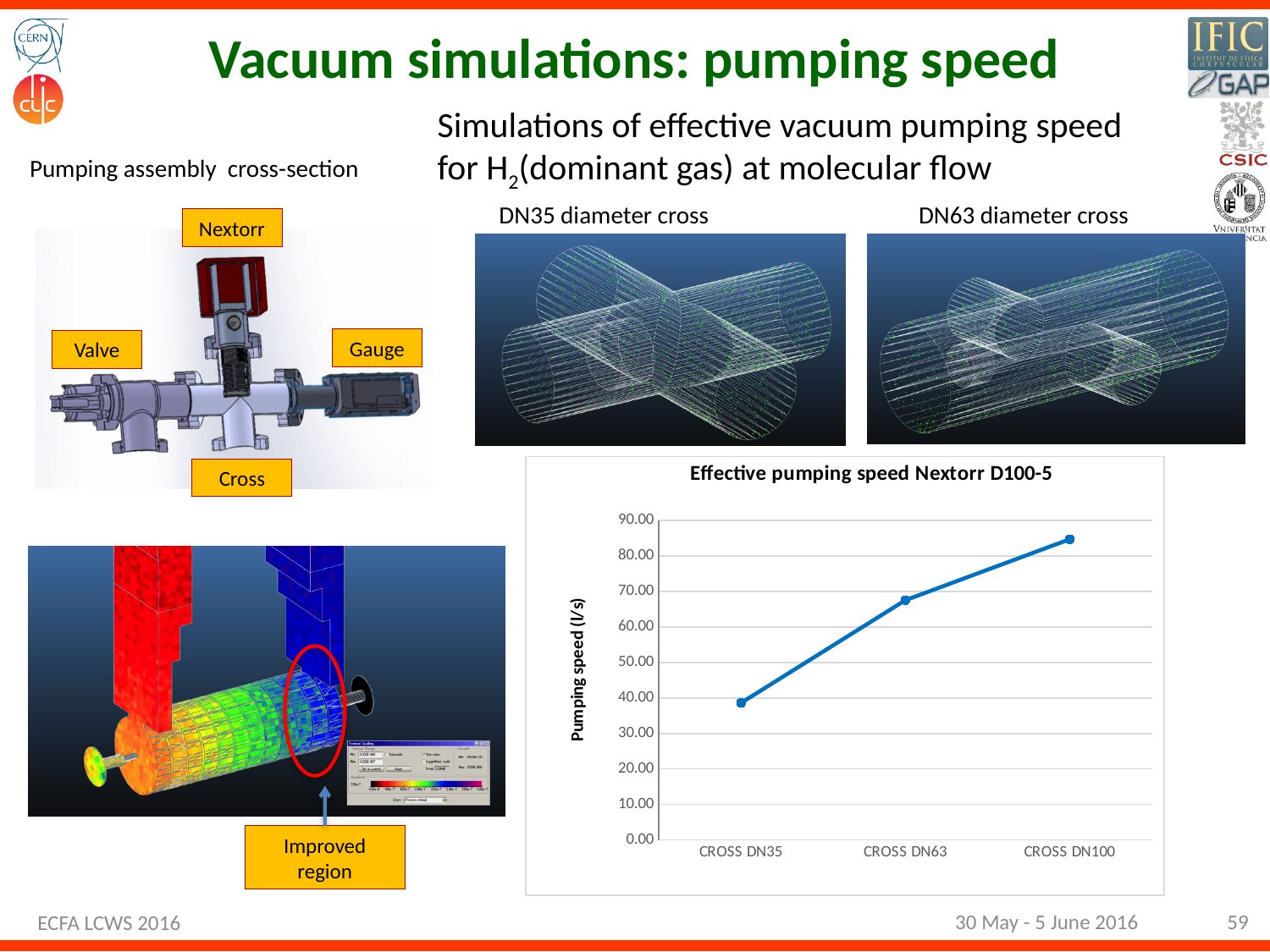
Is the pumping speed for CROSS DN63 greater or less than 60.00? greater What kind of chart is shown on the slide? line chart Is the pumping speed for CROSS DN35 greater or less than 40.00? less Does the pumping speed rise or fall from CROSS DN35 to CROSS DN100? rise Which has a higher pumping speed, CROSS DN63 or CROSS DN35? CROSS DN63 Is the pumping speed for CROSS DN100 greater or less than 80.00? greater What is the label of the vertical axis of the chart? Pumping speed (l/s) What is the title of the chart? Effective pumping speed Nextorr D100-5 Which category has the lowest pumping speed in the chart? CROSS DN35 How many categories are plotted on the x axis of the chart? 3 Which category has the highest pumping speed in the chart? CROSS DN100